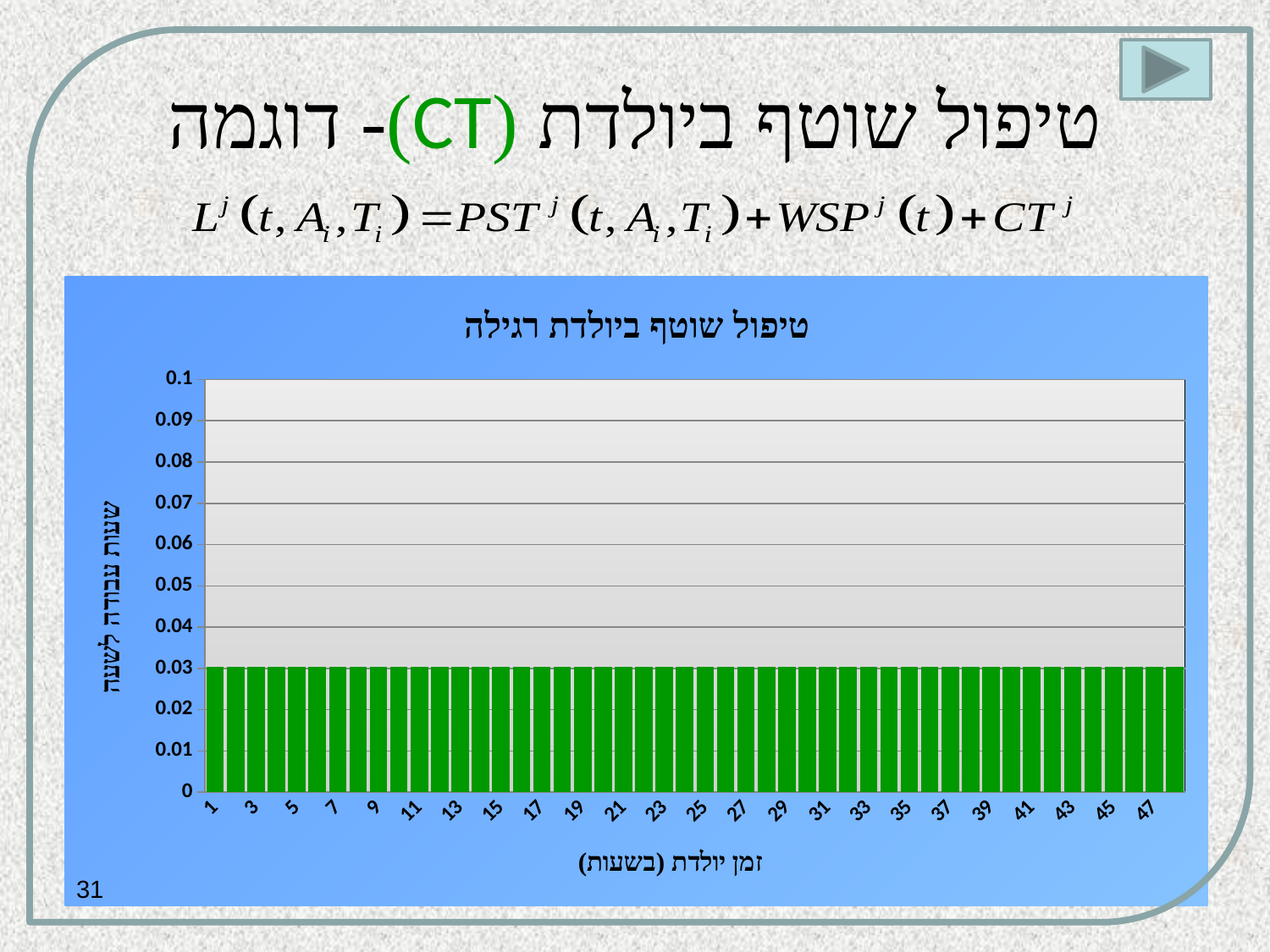
What is the highest value shown on the y axis? 0.1 Is the value for hour 35 greater or less than 0.02? greater What kind of chart is shown on the slide? bar chart What is the value for hour 47 on the chart? 0.03 Do the values rise, fall, or stay constant as the hour increases along the x axis? stay constant What is the value for hour 1 on the chart? 0.03 Is the value for hour 13 greater or less than 0.05? less What is the value for hour 25 on the chart? 0.03 What colour are the bars in the chart? green